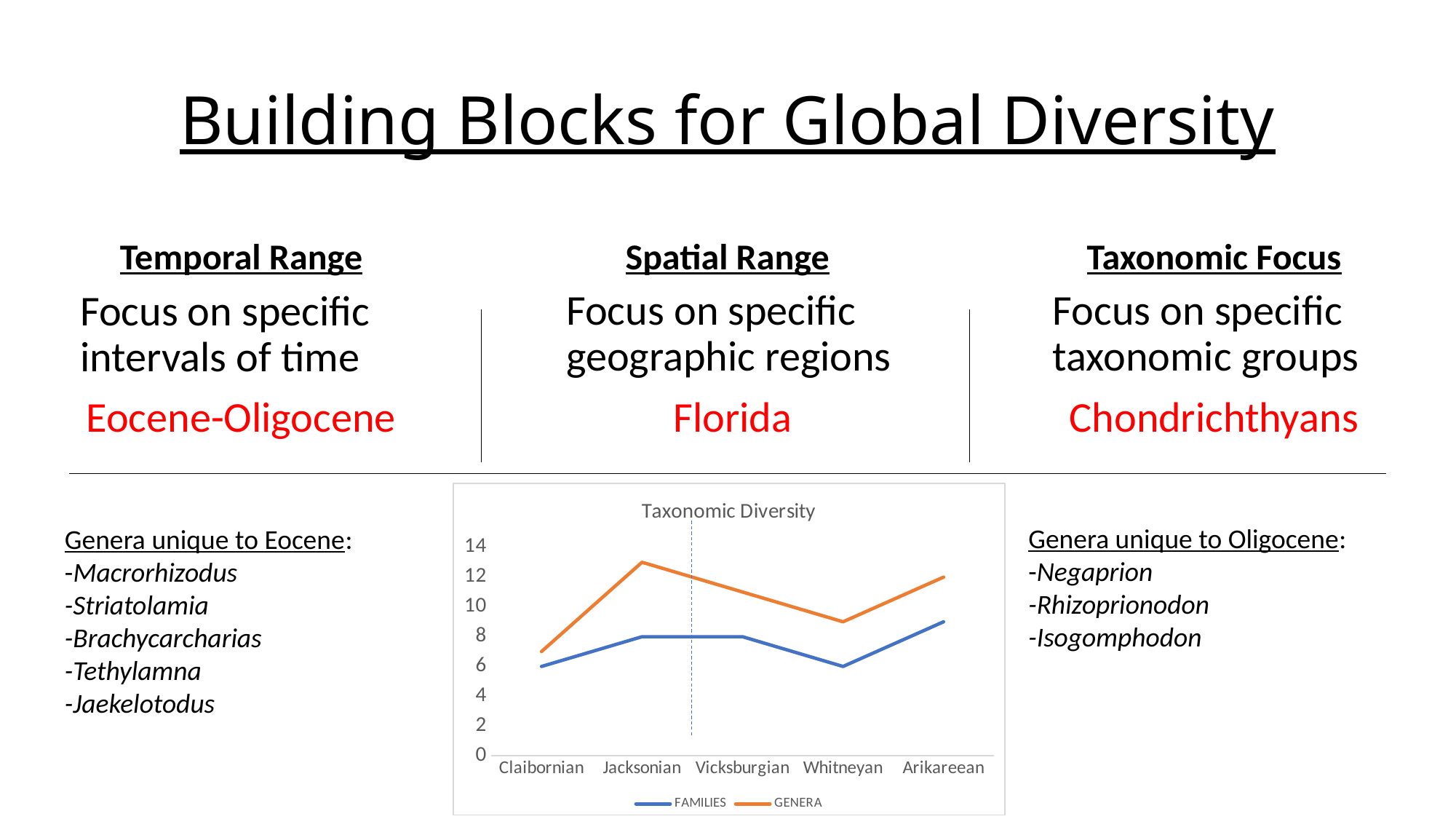
Which category has the highest FAMILIES value? Arikareean Is the FAMILIES value for Whitneyan greater or less than 8? less Which category has the highest GENERA value? Jacksonian How many series does the chart's legend list? 2 What kind of chart is shown on the slide? line chart Does the GENERA line rise or fall from Jacksonian to Whitneyan? fall Which is larger at Arikareean, the GENERA value or the FAMILIES value? GENERA What is the title of the chart on the slide? Taxonomic Diversity How many categories are shown along the x axis of the chart? 5 Which series is drawn in orange in the chart? GENERA Is the GENERA value for Whitneyan greater or less than 10? less Is the GENERA value for Jacksonian greater or less than 12? greater